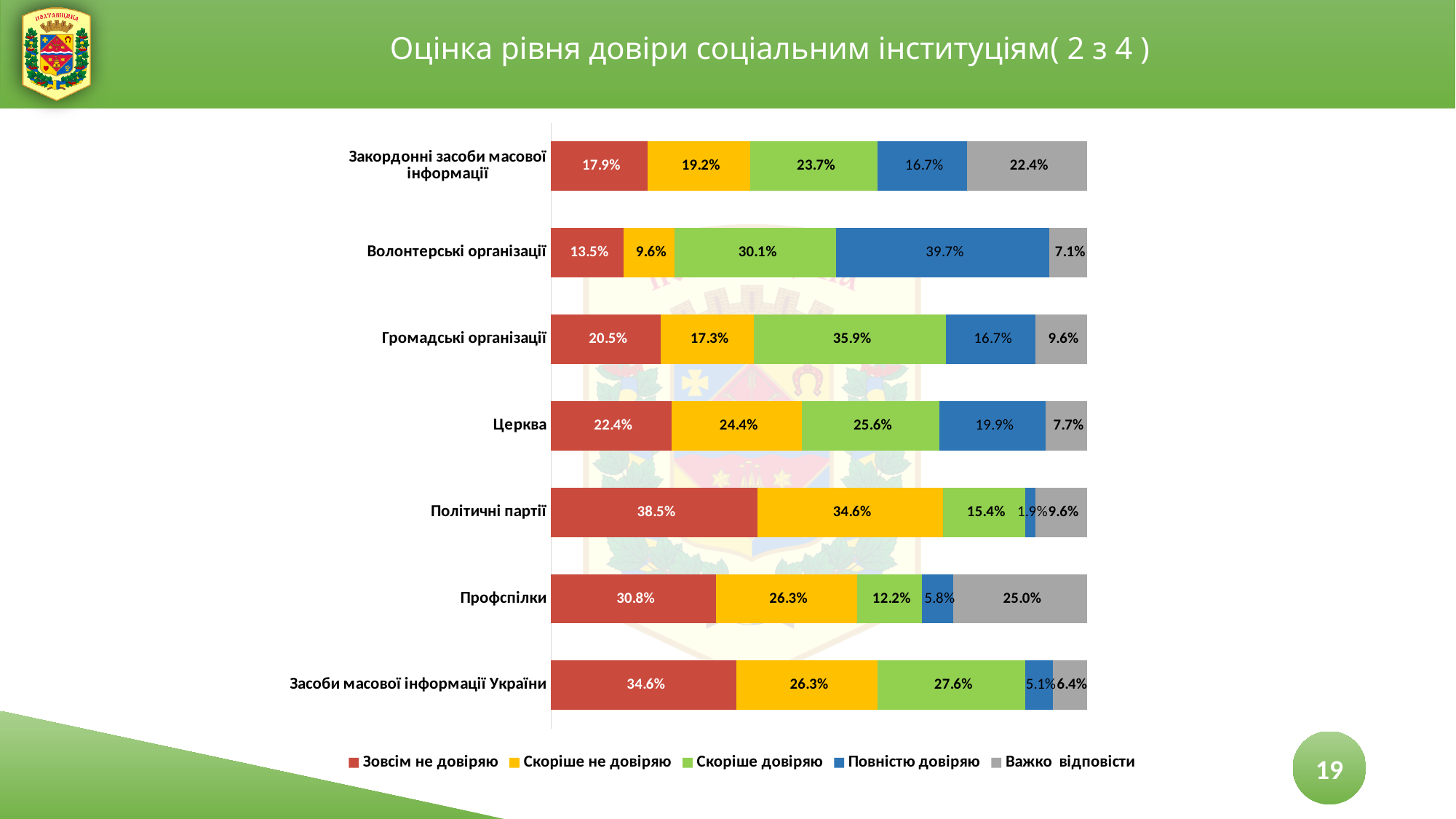
What is the value of "Повністю довіряю" for "Волонтерські організації"? 39.7% Which is larger for "Церква": "Скоріше довіряю" or "Повністю довіряю"? Скоріше довіряю What is the value of "Зовсім не довіряю" for "Політичні партії"? 38.5% How many institutions (categories) are shown in the chart? 7 What is the value of "Важко відповісти" for "Профспілки"? 25.0% What is the total of the stacked bar for "Волонтерські організації"? 100.0% Which institution has the highest value for "Повністю довіряю"? Волонтерські організації How many series does the legend list? 5 What kind of chart is shown on the slide? Stacked bar chart Which institution has the lowest value for "Повністю довіряю"? Політичні партії What is the difference between "Зовсім не довіряю" and "Скоріше не довіряю" for "Політичні партії"? 3.9% Which institution has the highest value for "Зовсім не довіряю"? Політичні партії